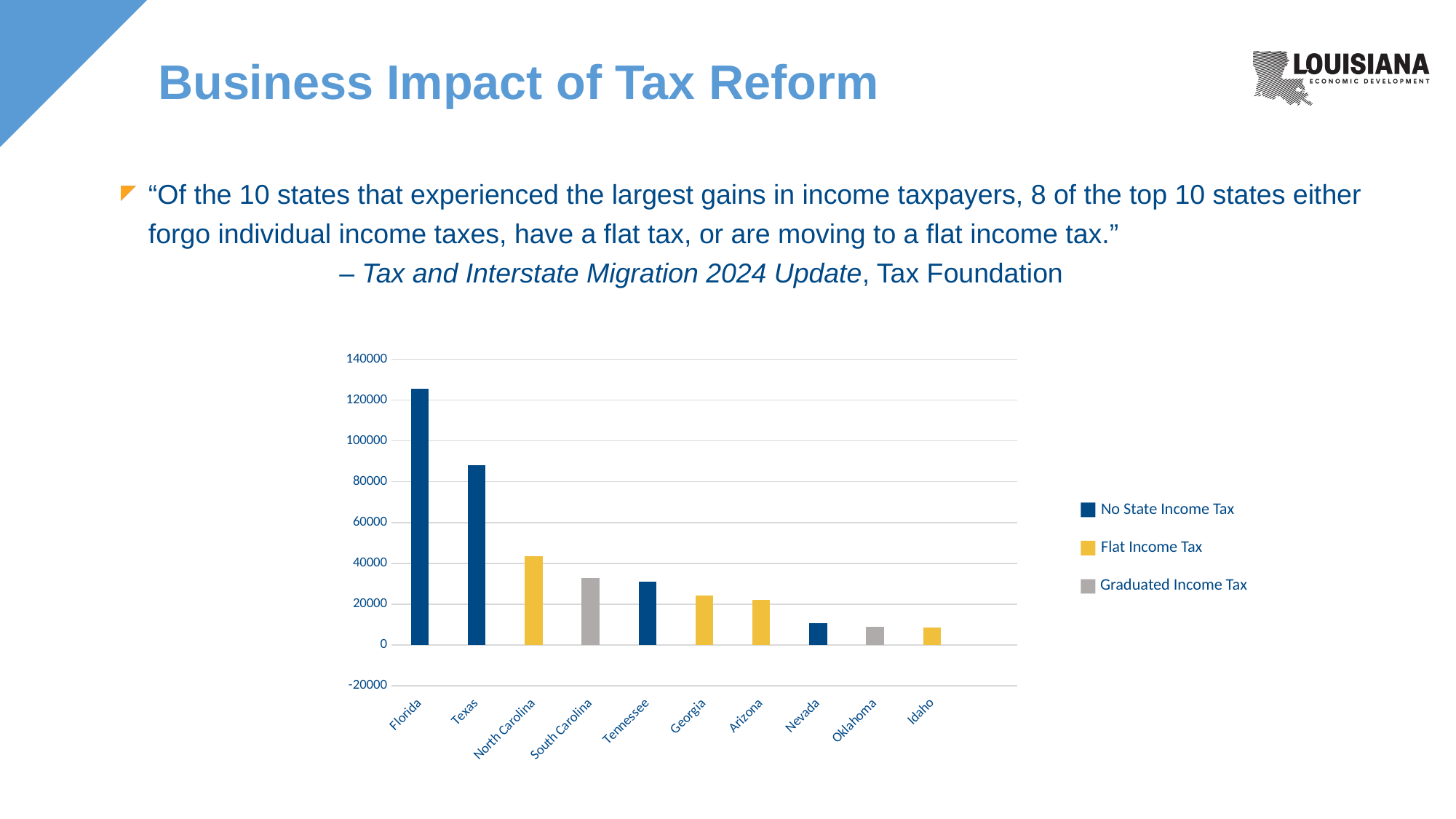
Which is larger, the value for North Carolina or the value for South Carolina? North Carolina Do the values generally rise or fall moving from Florida to Idaho along the x axis? fall What kind of chart is shown on the slide? bar chart Which legend series does the Florida bar belong to? No State Income Tax Is the value for North Carolina greater or less than 40000? greater How many series does the chart's legend list? 3 What colour represents Flat Income Tax in the chart's legend? yellow Which state has the highest value in the chart? Florida Is the value for Nevada greater or less than 20000? less Is the value for Florida greater or less than 120000? greater How many states are shown on the x axis of the chart? 10